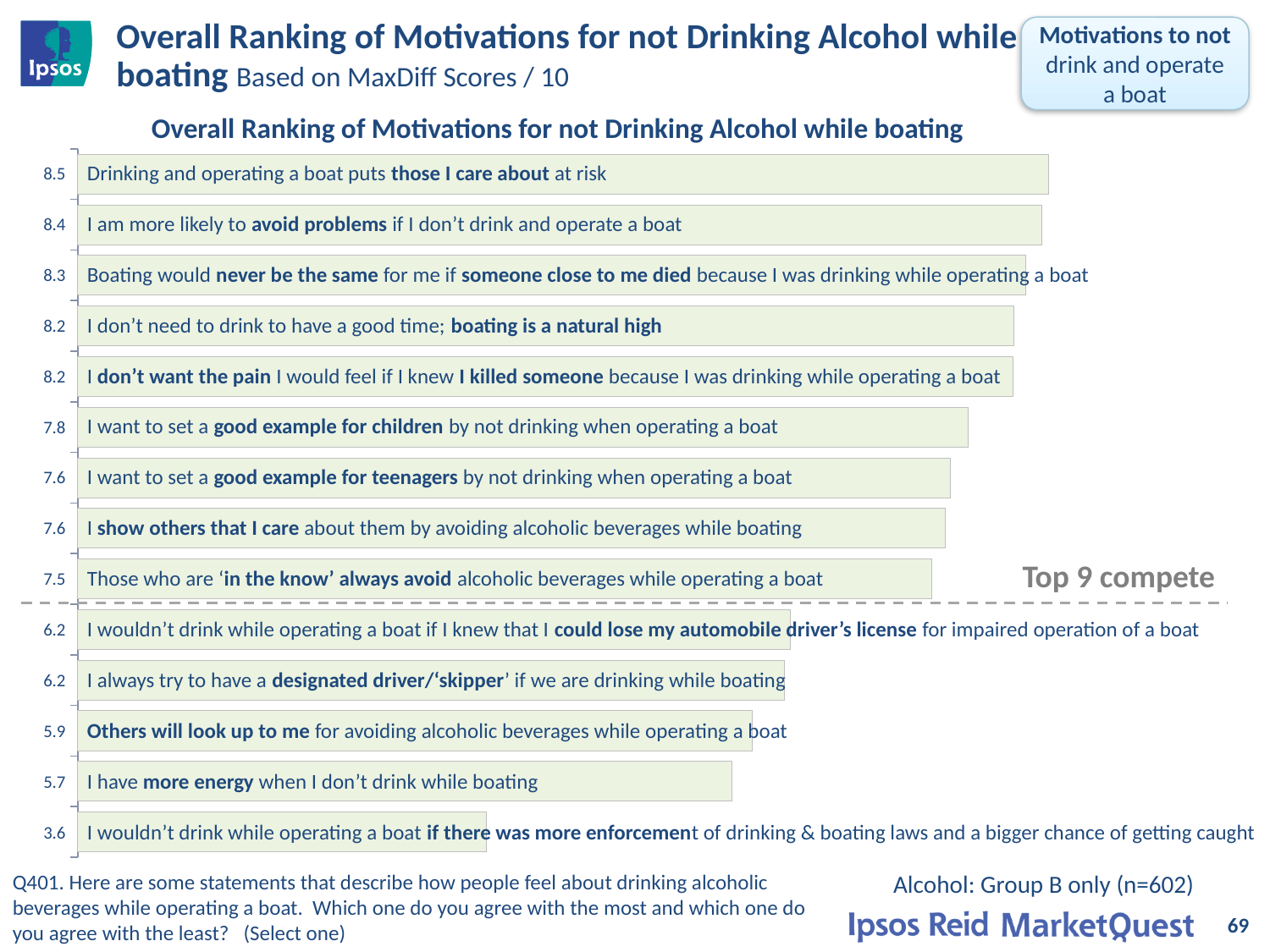
What is the difference between the score for "I am more likely to avoid problems" and the score for "Others will look up to me"? 2.5 How many statements are plotted on the chart? 14 Which statement has the highest score on the chart? Drinking and operating a boat puts those I care about at risk Which scores higher: setting a good example for children or setting a good example for teenagers? Good example for children What annotation appears next to the dashed line separating the top group of bars? Top 9 compete What is the score for "I have more energy when I don't drink while boating"? 5.7 What score is shown for the statement about having a designated driver/'skipper'? 6.2 What is the difference between the highest score (8.5) and the lowest score (3.6)? 4.9 What type of chart is shown on the slide? Bar chart Which statement has the lowest score on the chart? I wouldn't drink while operating a boat if there was more enforcement of drinking & boating laws and a bigger chance of getting caught What is the MaxDiff score for "Drinking and operating a boat puts those I care about at risk"? 8.5 Do the scores increase or decrease going from the top bar to the bottom bar? Decrease